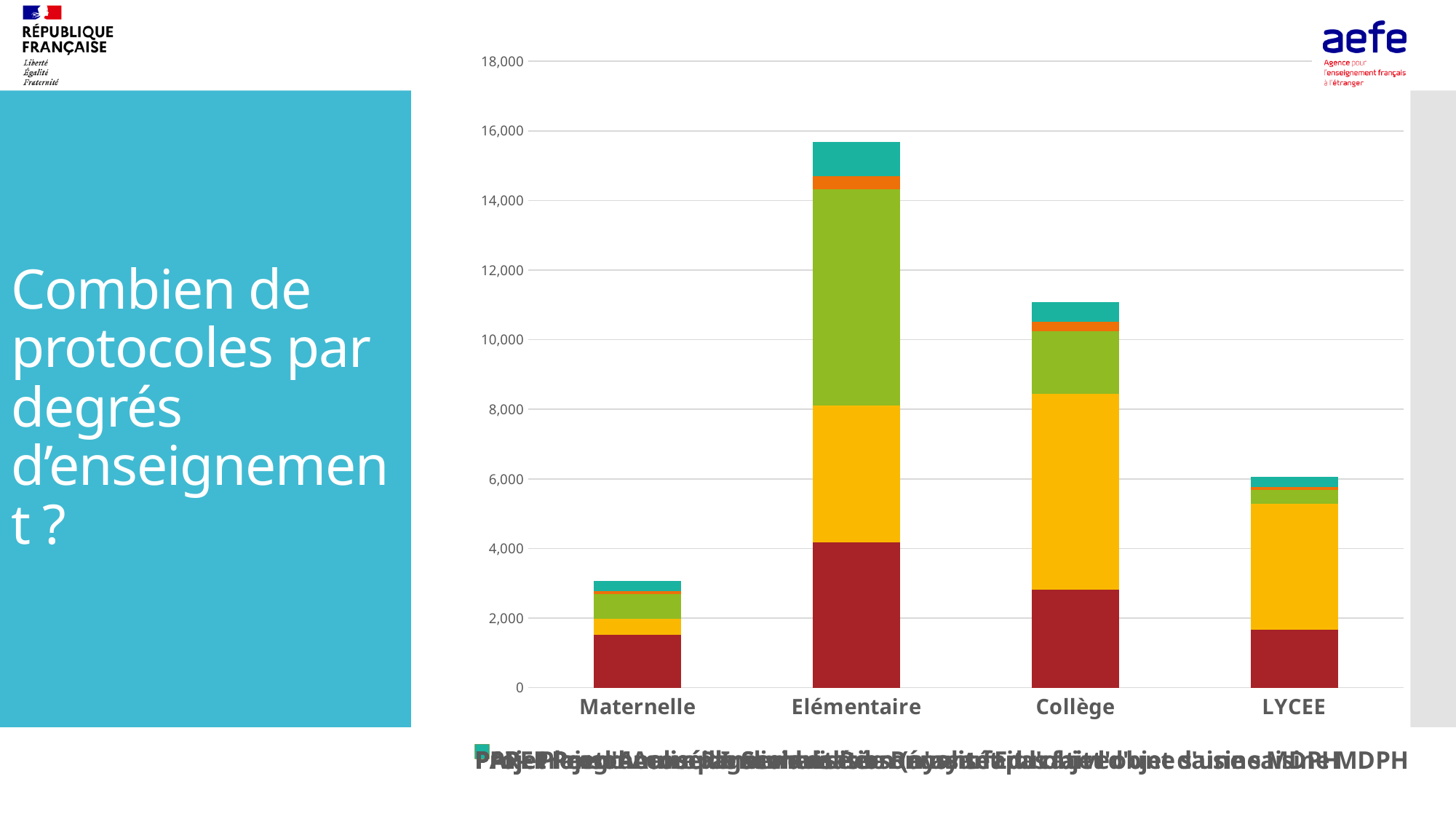
Which category has the shortest stacked bar? Maternelle Is the total of the LYCEE bar greater or less than 8,000? less Is the total of the Elémentaire bar greater or less than 14,000? greater How many categories are shown on the x axis of the chart? 4 What kind of chart is shown on the slide? stacked bar chart Is the total of the Collège bar greater or less than 10,000? greater Which stacked bar is taller, Collège or LYCEE? Collège Which stacked bar is taller, Maternelle or LYCEE? LYCEE What colour is the bottom segment of each stacked bar? red Which category has the tallest stacked bar? Elémentaire